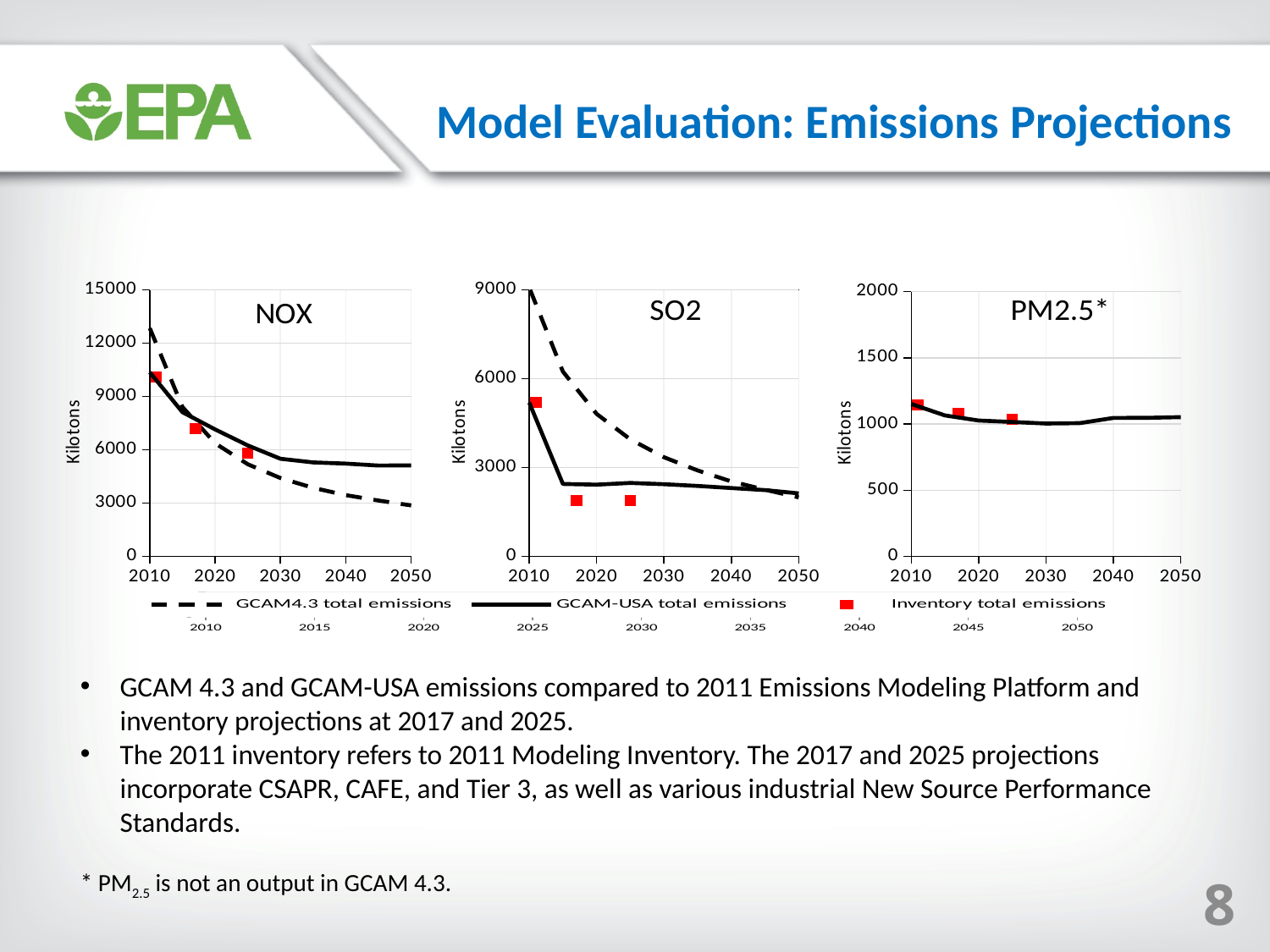
In the SO2 chart, which series is higher at 2020: GCAM4.3 total emissions or GCAM-USA total emissions? GCAM4.3 total emissions In the NOX chart, is the GCAM-USA total emissions value at 2050 greater or less than 6000 kilotons? less How many series does the shared legend below the charts list? 3 What is the y-axis label on the three charts? Kilotons In the SO2 chart, does the GCAM-USA total emissions line rise or fall overall from 2010 to 2050? fall In the SO2 chart, is the GCAM-USA total emissions value at 2020 greater or less than 3000 kilotons? less In the PM2.5* chart, is the GCAM-USA total emissions value at 2050 greater or less than 1500 kilotons? less In the NOX chart, which series is higher at 2050: GCAM4.3 total emissions or GCAM-USA total emissions? GCAM-USA total emissions In the NOX chart, does the GCAM4.3 total emissions line rise or fall from 2010 to 2050? fall How many charts are shown on the slide? 3 What kind of chart is the NOX chart? line chart